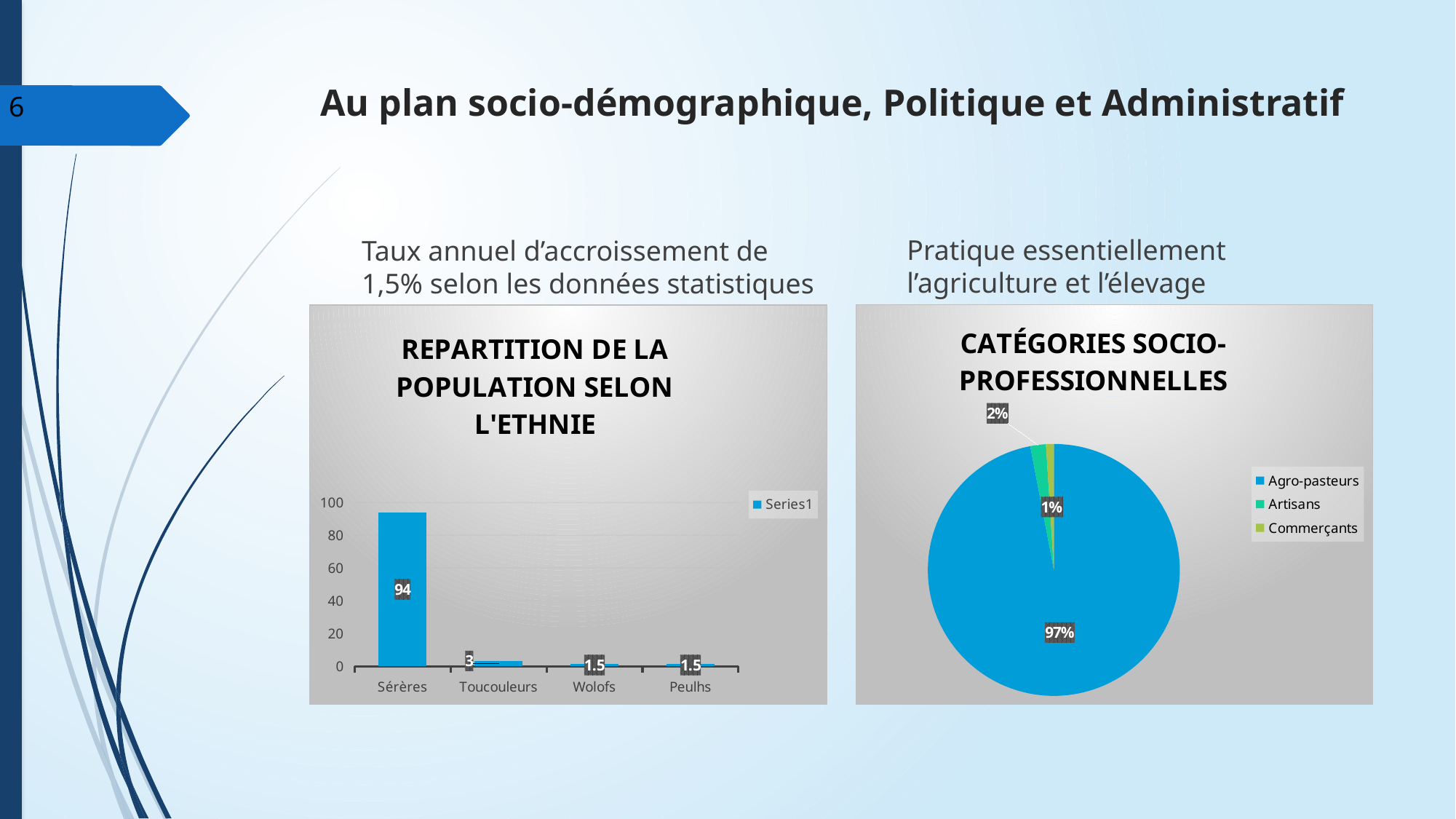
What kind of chart is the chart on the left of the slide? bar chart In the pie chart 'CATÉGORIES SOCIO-PROFESSIONNELLES', what share do Agro-pasteurs represent? 97% In the bar chart 'REPARTITION DE LA POPULATION SELON L'ETHNIE', is the value for Sérères greater or less than 80? greater In the bar chart 'REPARTITION DE LA POPULATION SELON L'ETHNIE', how many ethnic groups are shown on the x axis? 4 How many categories does the legend of the pie chart 'CATÉGORIES SOCIO-PROFESSIONNELLES' list? 3 In the bar chart 'REPARTITION DE LA POPULATION SELON L'ETHNIE', what is the value for Sérères? 94 In the pie chart 'CATÉGORIES SOCIO-PROFESSIONNELLES', which category has the smallest slice? Commerçants In the bar chart 'REPARTITION DE LA POPULATION SELON L'ETHNIE', which ethnic group has the highest value? Sérères In the pie chart 'CATÉGORIES SOCIO-PROFESSIONNELLES', what share do Artisans represent? 2% In the bar chart 'REPARTITION DE LA POPULATION SELON L'ETHNIE', what is the value for Toucouleurs? 3 In the bar chart 'REPARTITION DE LA POPULATION SELON L'ETHNIE', what is the difference between the values for Sérères and Toucouleurs? 91 In the bar chart 'REPARTITION DE LA POPULATION SELON L'ETHNIE', what is the value for Wolofs? 1.5